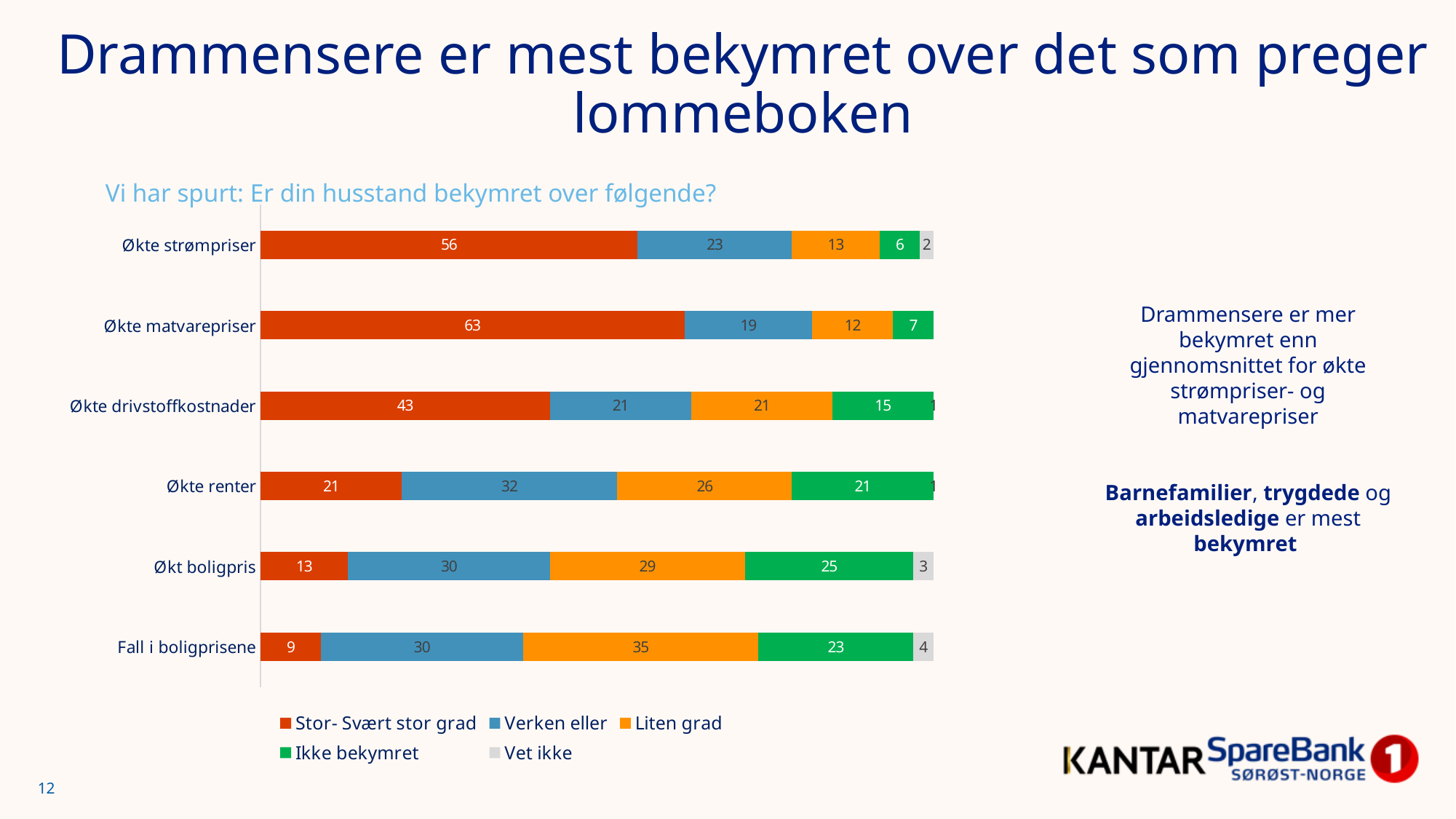
What is the value of 'Ikke bekymret' for 'Økt boligpris'? 25 How many series does the legend list? 5 What is the total of the stacked bar for 'Økte strømpriser'? 100 Which category has the highest value for 'Stor- Svært stor grad'? Økte matvarepriser Which has the larger 'Verken eller' value: 'Økte renter' or 'Økte strømpriser'? Økte renter What is the value of 'Liten grad' for 'Fall i boligprisene'? 35 What colour represents 'Vet ikke' in the legend? Grey How many categories are shown in the chart? 6 What is the difference in 'Stor- Svært stor grad' between 'Økte matvarepriser' and 'Økte strømpriser'? 7 What is the value of 'Stor- Svært stor grad' for 'Økte matvarepriser'? 63 What kind of chart is shown on the slide? Stacked bar chart Which category has the lowest value for 'Stor- Svært stor grad'? Fall i boligprisene